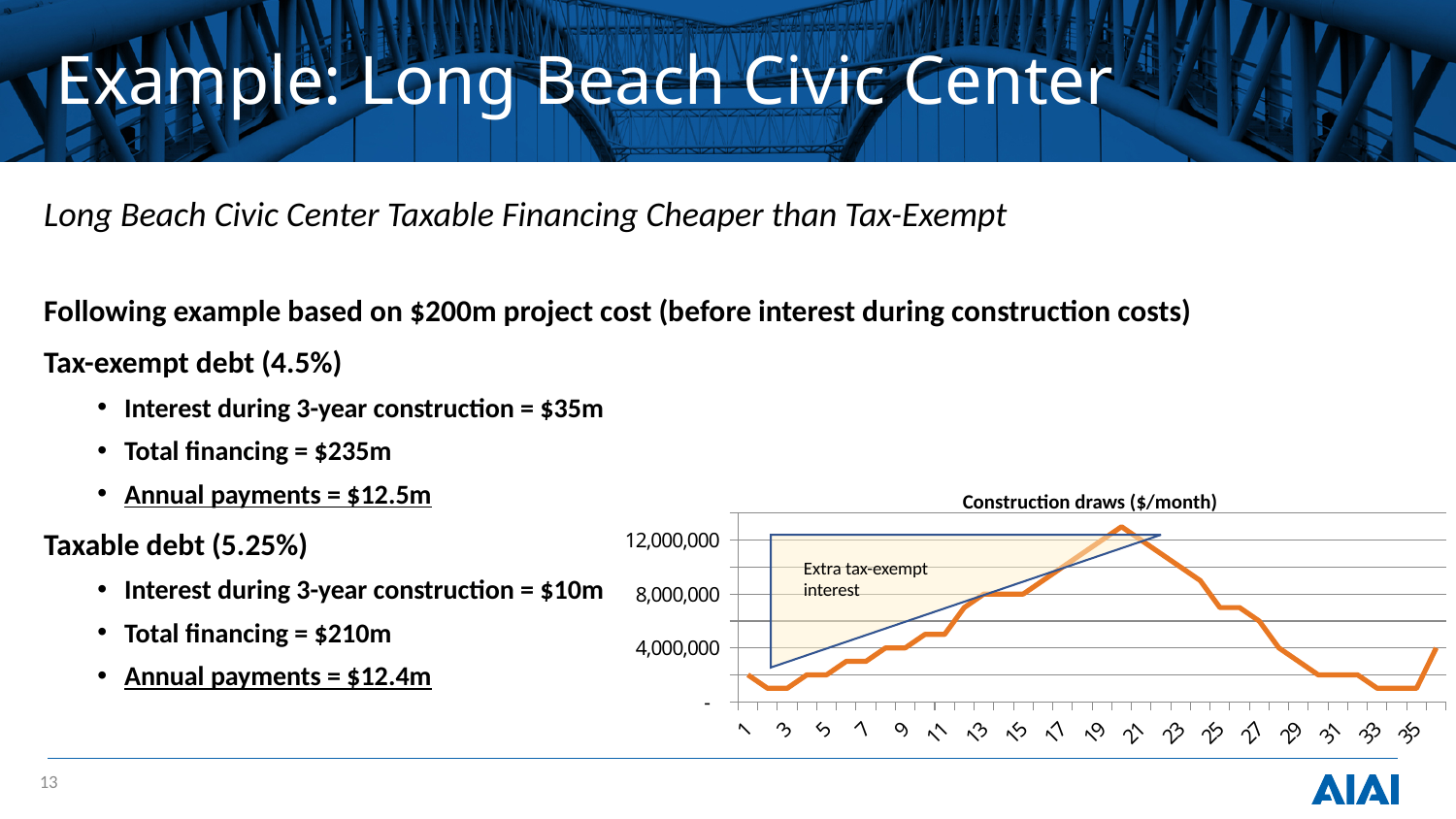
Do the construction draw values rise or fall from month 21 to month 33? fall Is the construction draw value for month 1 greater or less than 4,000,000? less What is the title of the chart on the slide? Construction draws ($/month) Is the construction draw value for month 29 greater or less than 8,000,000? less Is the construction draw value for month 13 greater or less than 4,000,000? greater What text label appears inside the shaded triangle on the chart? Extra tax-exempt interest Which month has the larger construction draw value, month 13 or month 29? month 13 What kind of chart is shown on the slide? line chart Which month has the larger construction draw value, month 5 or month 25? month 25 Do the construction draw values rise or fall from month 1 to month 19? rise